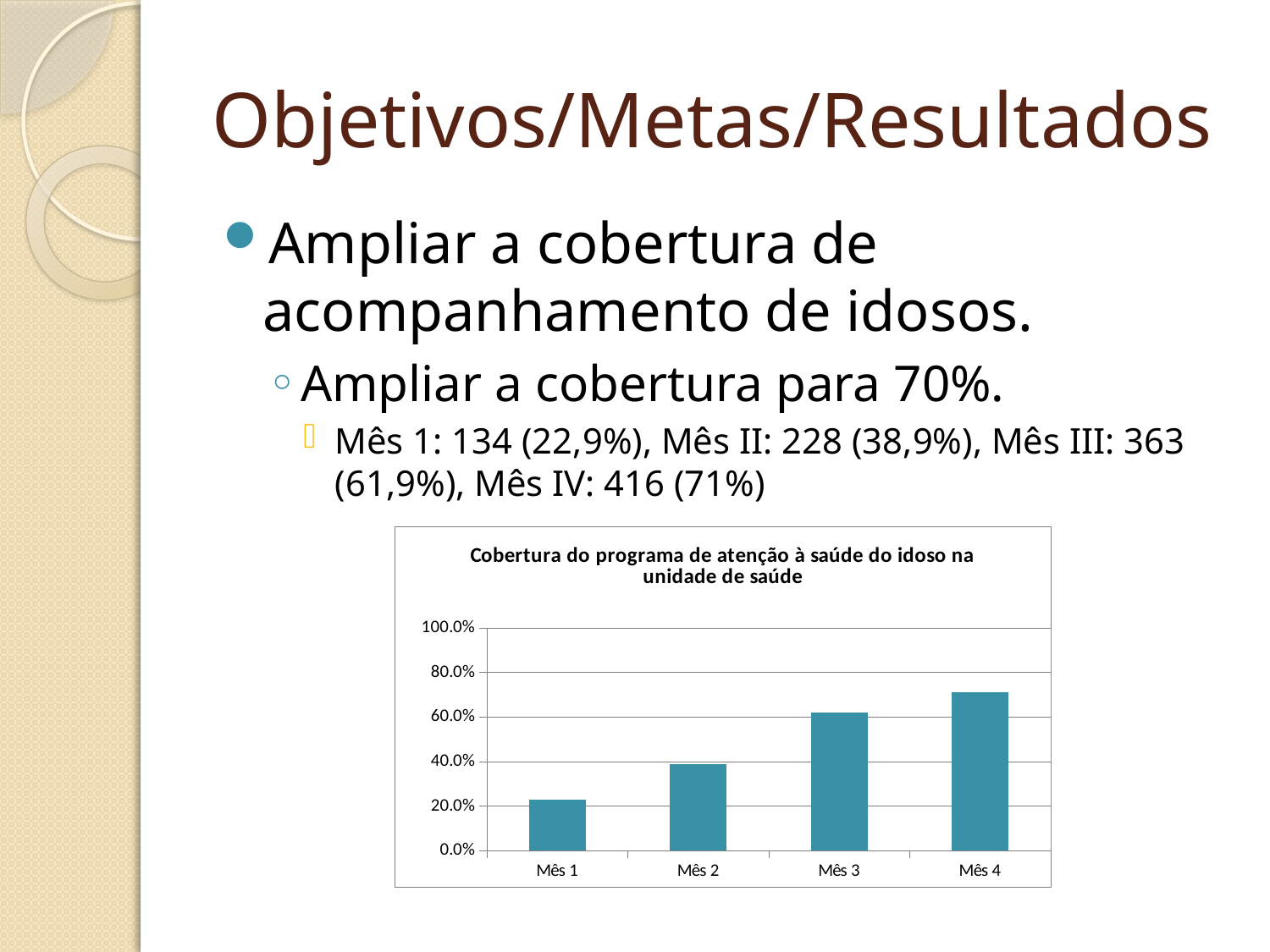
Is the value for Mês 1 greater or less than 40.0%? less Is the value for Mês 2 greater or less than 20.0%? greater Is the value for Mês 4 greater or less than 80.0%? less What is the title of the chart? Cobertura do programa de atenção à saúde do idoso na unidade de saúde Which month has the highest bar in the chart? Mês 4 Which month has the lowest bar in the chart? Mês 1 What is the highest value shown on the vertical axis of the chart? 100.0% Do the values rise or fall from Mês 1 to Mês 4? rise What kind of chart is shown on the slide? bar chart How many categories (months) are plotted in the chart? 4 Which is larger, the value for Mês 2 or the value for Mês 3? Mês 3